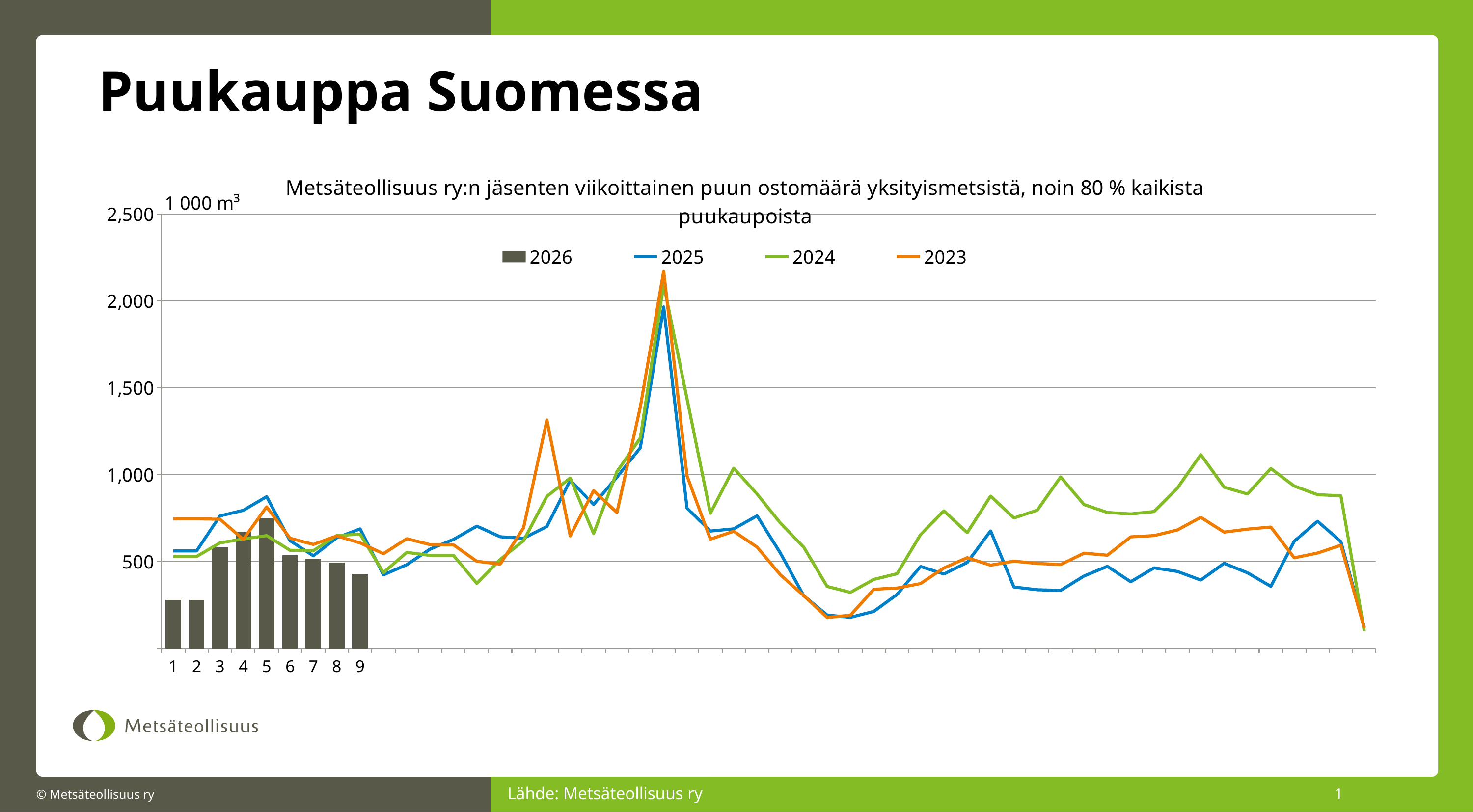
Is the 2026 bar for week 5 greater or less than 500? greater How many bars are plotted for the 2026 series? 9 What kind of chart is shown on the slide? A combined bar and line chart Do the 2026 bars rise or fall from week 5 to week 9? Fall Which years are listed in the chart legend? 2026, 2025, 2024, 2023 Which week has the highest 2026 bar? 5 Is the peak value of the 2023 line greater or less than 2,000? greater How many series does the chart legend list? 4 Which series reaches the highest peak on the chart? 2023 Which is larger, the 2026 bar for week 3 or the 2026 bar for week 1? Week 3 What unit is shown on the vertical axis of the chart? 1 000 m³ Is the 2026 bar for week 1 greater or less than 500? less